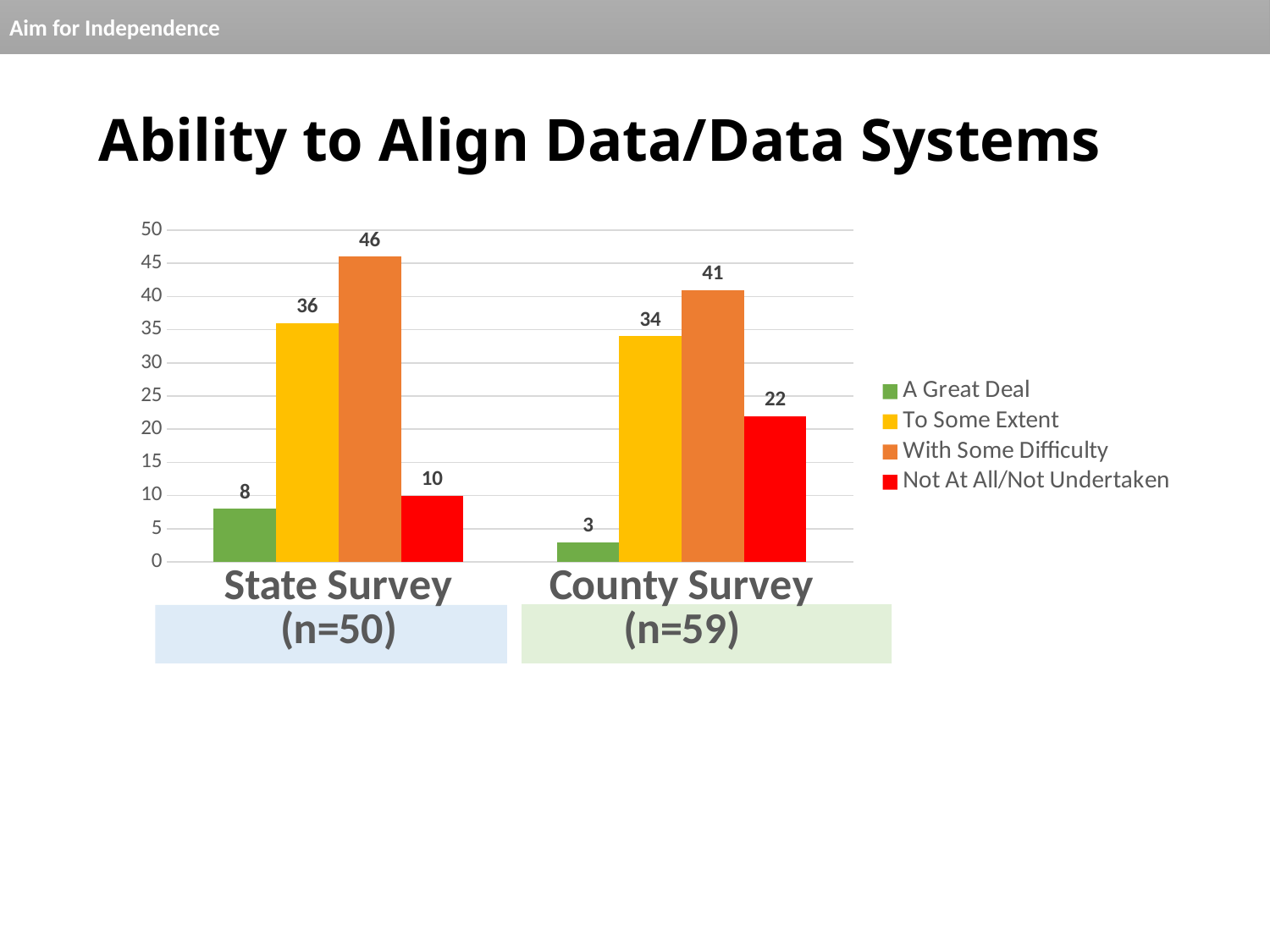
What is the value for "A Great Deal" in the County Survey (n=59)? 3 Which is larger: "Not At All/Not Undertaken" in the State Survey or in the County Survey? County Survey What is the value for "With Some Difficulty" in the State Survey (n=50)? 46 What is the difference between "To Some Extent" and "Not At All/Not Undertaken" in the State Survey (n=50)? 26 What kind of chart is shown on the slide? Bar chart What is the value for "Not At All/Not Undertaken" in the County Survey (n=59)? 22 What colour represents "A Great Deal" in the chart? Green How many series does the legend list? 4 Is the value for "To Some Extent" in the County Survey greater or less than 30? greater Which response category has the highest value in the County Survey (n=59)? With Some Difficulty Which response category has the lowest value in the State Survey (n=50)? A Great Deal What is the difference between the "With Some Difficulty" values for the State Survey and the County Survey? 5